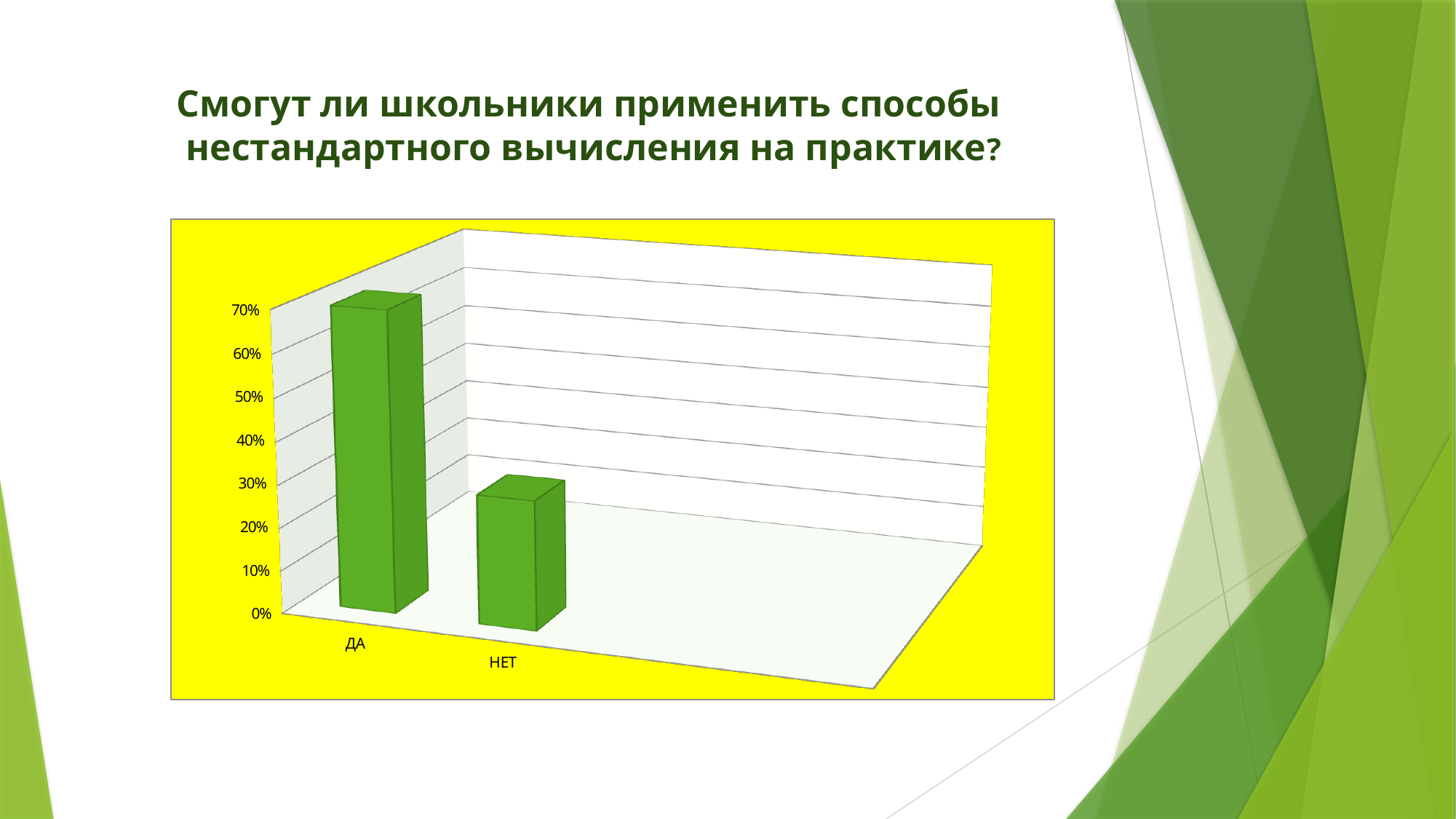
Is the value for ДА greater or less than 40%? greater Is the value for ДА greater or less than 50%? greater What kind of chart is shown on the slide? bar chart How many categories are shown on the x axis of the chart? 2 Which bar is taller, ДА or НЕТ? ДА Is the value for НЕТ greater or less than 50%? less Which category has the highest bar in the chart? ДА What colour are the bars in the chart? green What is the highest value shown on the vertical axis of the chart? 70% Which category has the lowest bar in the chart? НЕТ